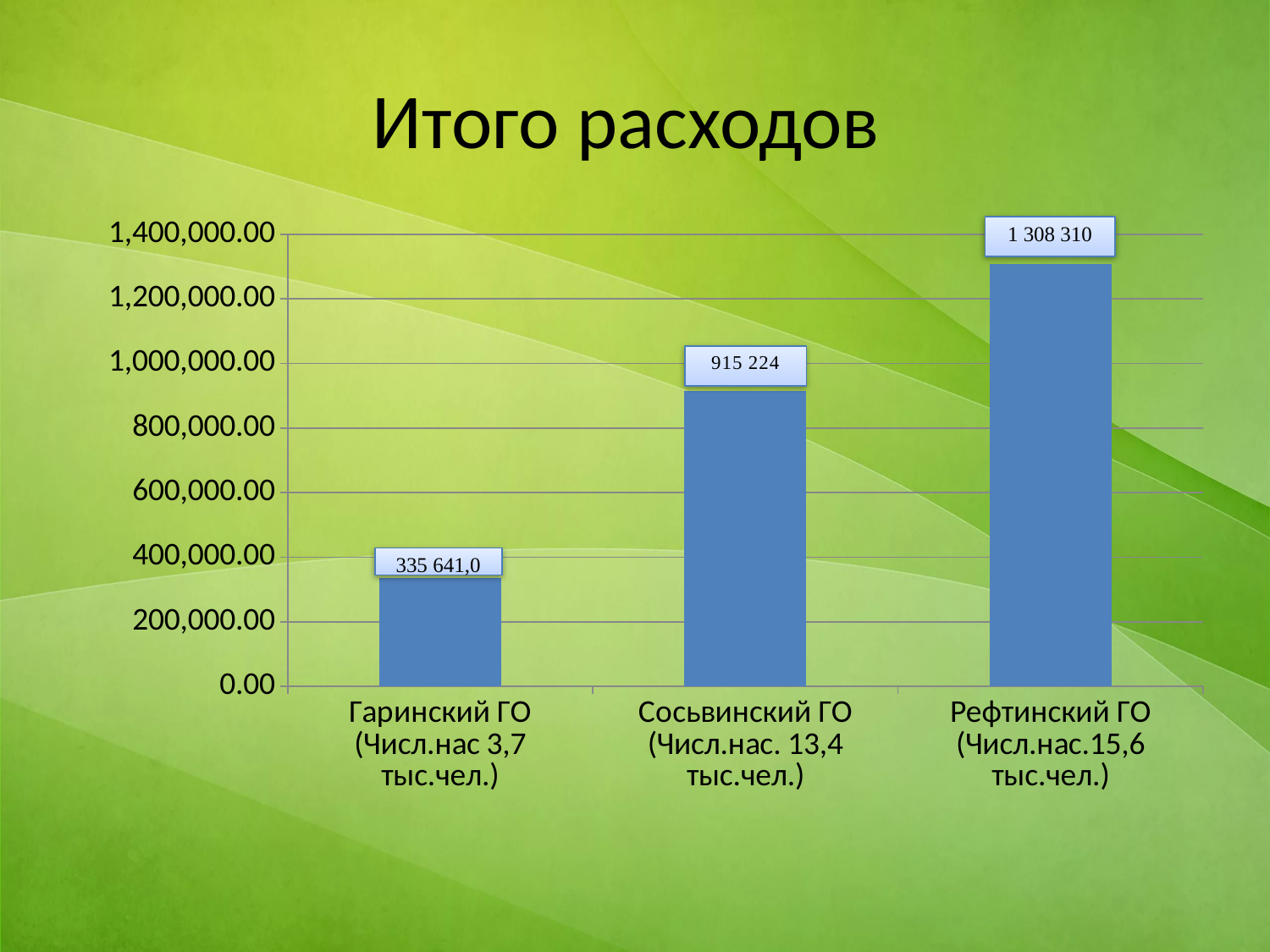
Is the value for Рефтинский ГО greater or less than 1,200,000.00? greater What is the value shown for Сосьвинский ГО? 915 224 Do the values rise or fall from left to right along the x axis? Rise How many categories are shown on the chart? 3 Which category has the lowest value? Гаринский ГО What is the value shown for Рефтинский ГО? 1 308 310 Which is larger, the value for Сосьвинский ГО or the value for Гаринский ГО? Сосьвинский ГО What is the difference between the values for Рефтинский ГО and Сосьвинский ГО? 393 086 What kind of chart is shown on the slide? Bar chart What is the value shown for Гаринский ГО? 335 641,0 Which category has the highest value? Рефтинский ГО Is the value for Сосьвинский ГО greater or less than 1,000,000.00? less